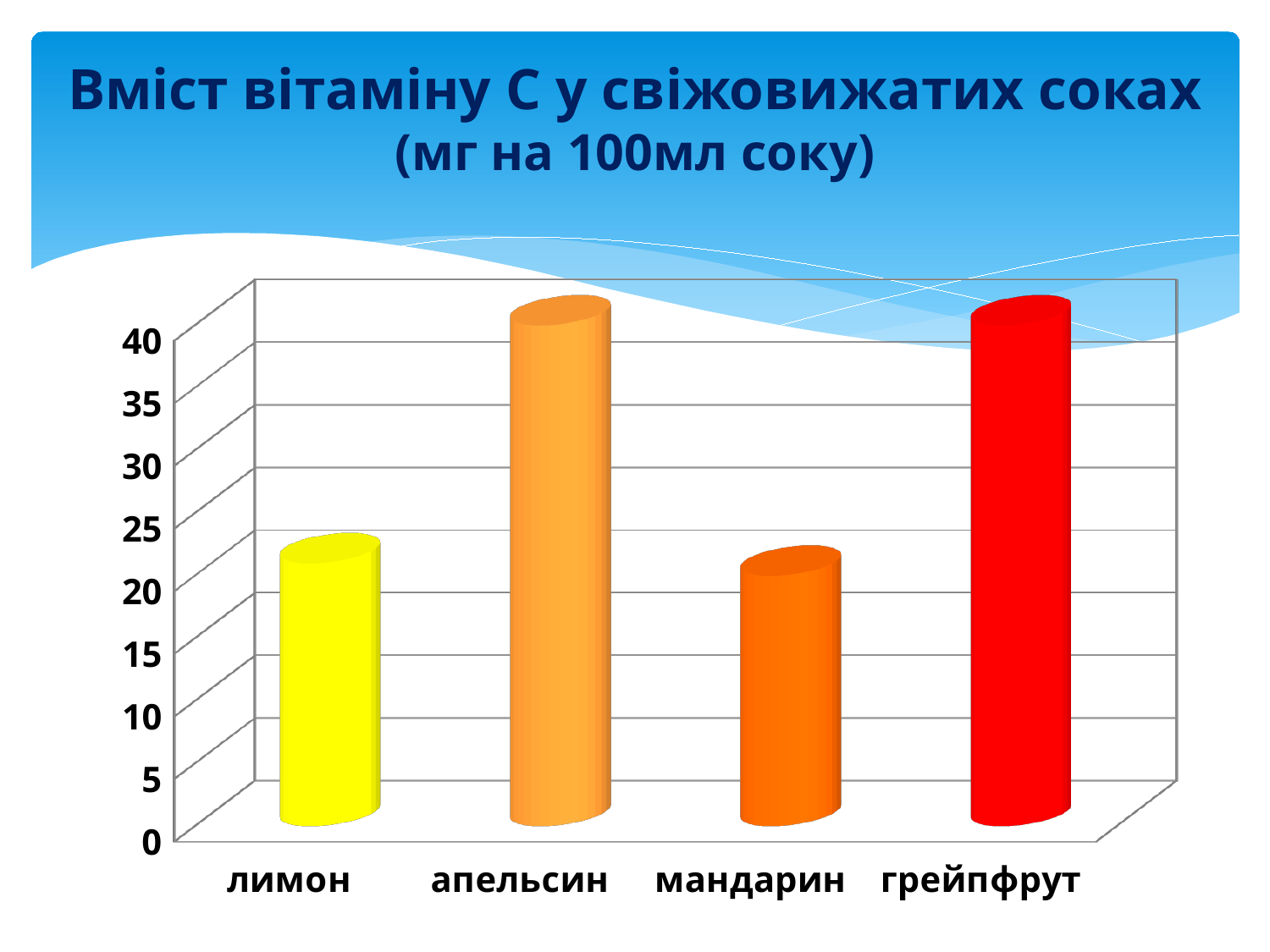
Which has a larger value, грейпфрут or мандарин? грейпфрут Is the value for мандарин greater or less than 10? greater Is the value for мандарин greater or less than 25? less Is the value for лимон greater or less than 30? less Which has a larger value, апельсин or лимон? апельсин What is the title of the chart on the slide? Вміст вітаміну С у свіжовижатих соках (мг на 100мл соку) How many categories (juices) are shown on the x axis of the chart? 4 What colour is the bar for грейпфрут? red What kind of chart is shown on the slide? bar chart